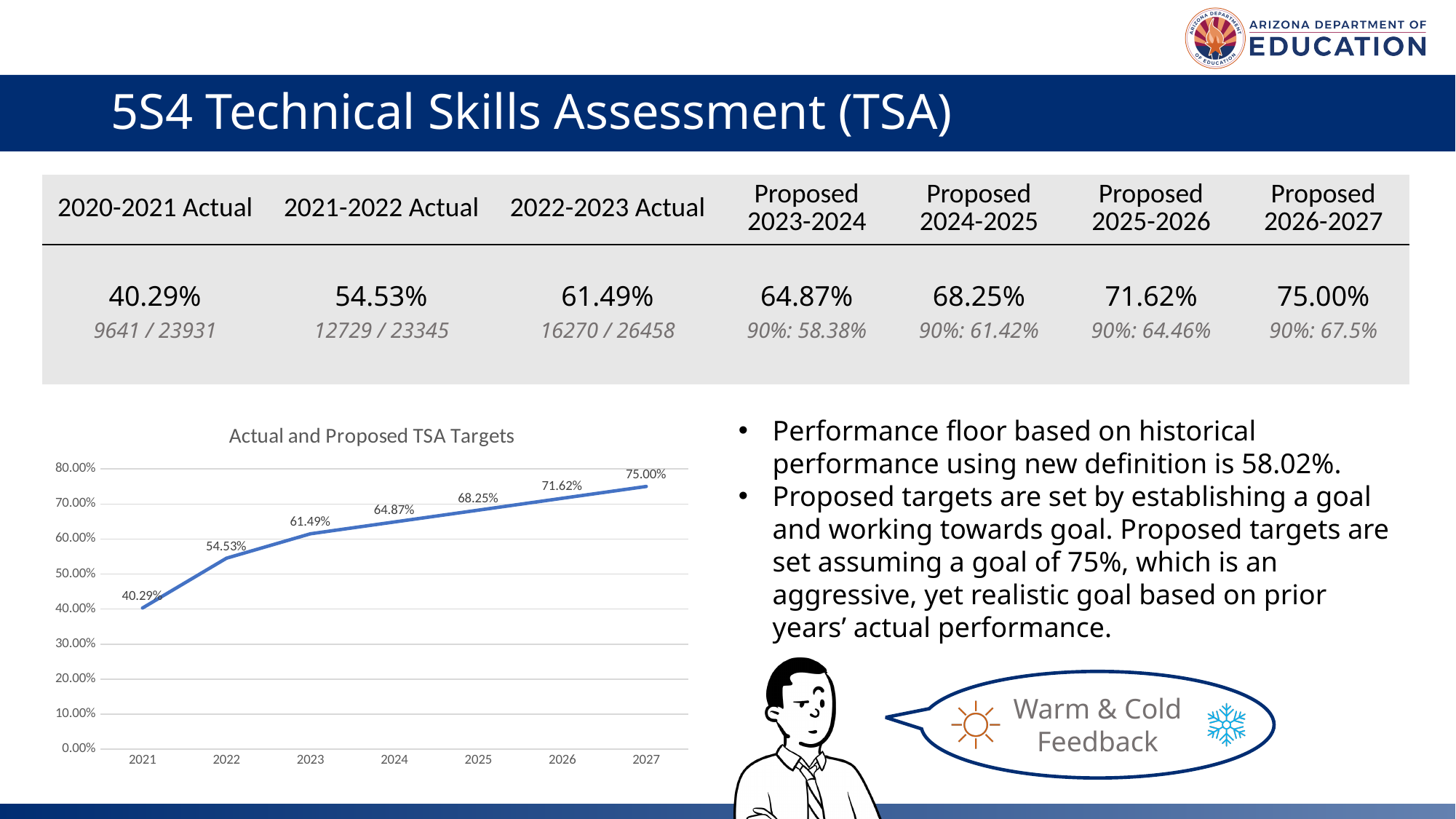
What is the value for 2027 in the chart? 75.00% Which is larger, the value for 2023 or the value for 2025? 2025 Is the value for 2026 greater or less than 70.00%? greater What is the difference between the values for 2022 and 2021? 14.24% Do the values rise or fall from 2021 to 2027? rise What is the title of the chart? Actual and Proposed TSA Targets Which year has the lowest value in the chart? 2021 What is the value for 2024 in the chart? 64.87% What is the value for 2021 in the chart? 40.29% What kind of chart is shown on the slide? line chart Which year has the highest value in the chart? 2027 How many years are plotted on the x axis of the chart? 7